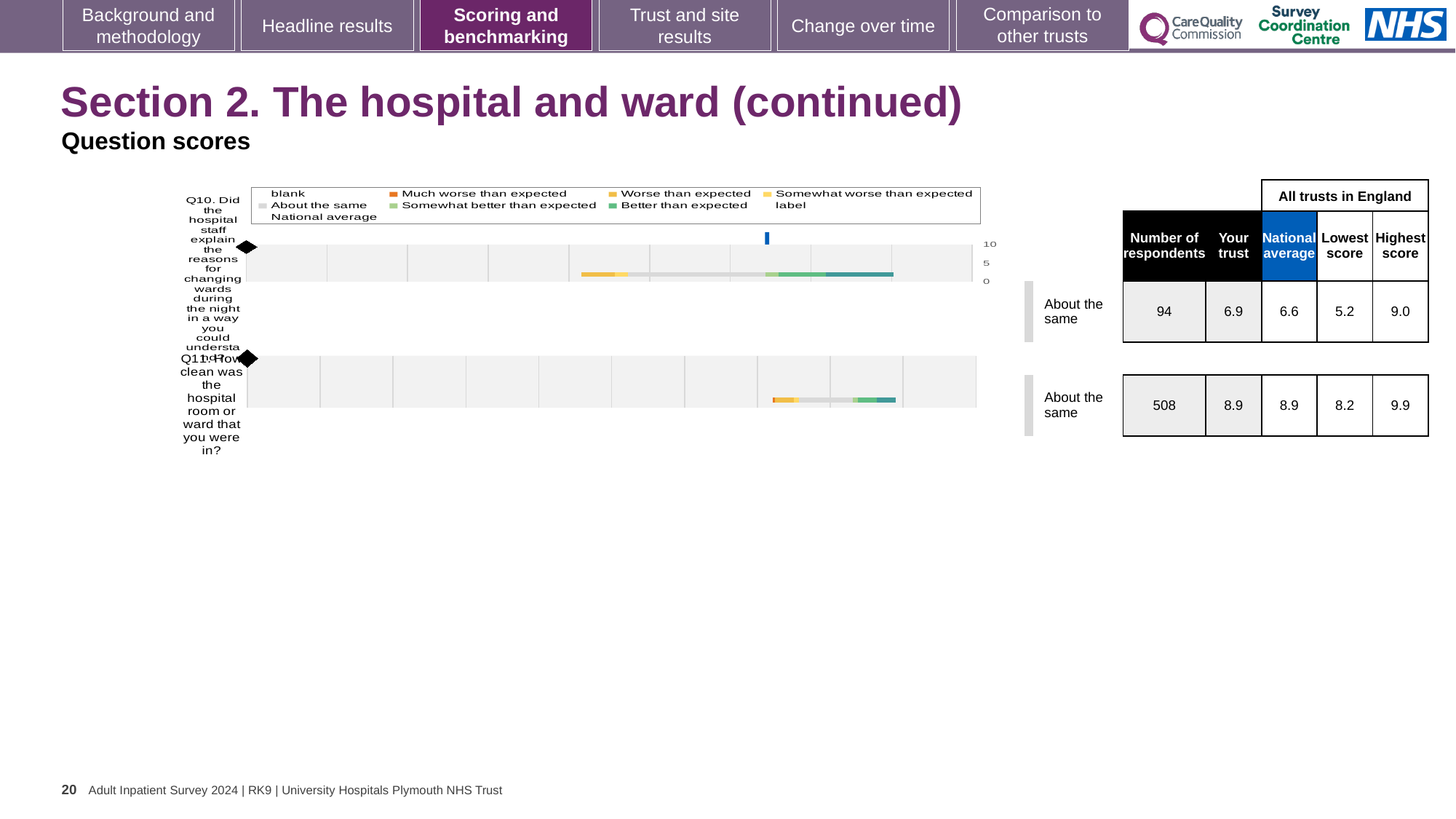
How many questions are charted on this slide? 2 What is the lowest score across all trusts in England for Q10? 5.2 What is the national average score for Q11 (how clean was the hospital room or ward)? 8.9 For Q10, which is larger: the 'Your trust' score or the national average? Your trust For Q11, what is the difference between the highest score and the lowest score across all trusts in England? 1.7 What kind of chart is used to show the Q10 and Q11 question scores? bar chart For Q10, what is the difference between the highest score and the lowest score across all trusts in England? 3.8 What is the highest tick value shown on the axis of the Q10 chart? 10 Which question had more respondents, Q10 or Q11? Q11 How many respondents answered Q11? 508 What benchmark category is shown for Q11? About the same What is the 'Your trust' score for Q10 (explaining reasons for changing wards during the night)? 6.9